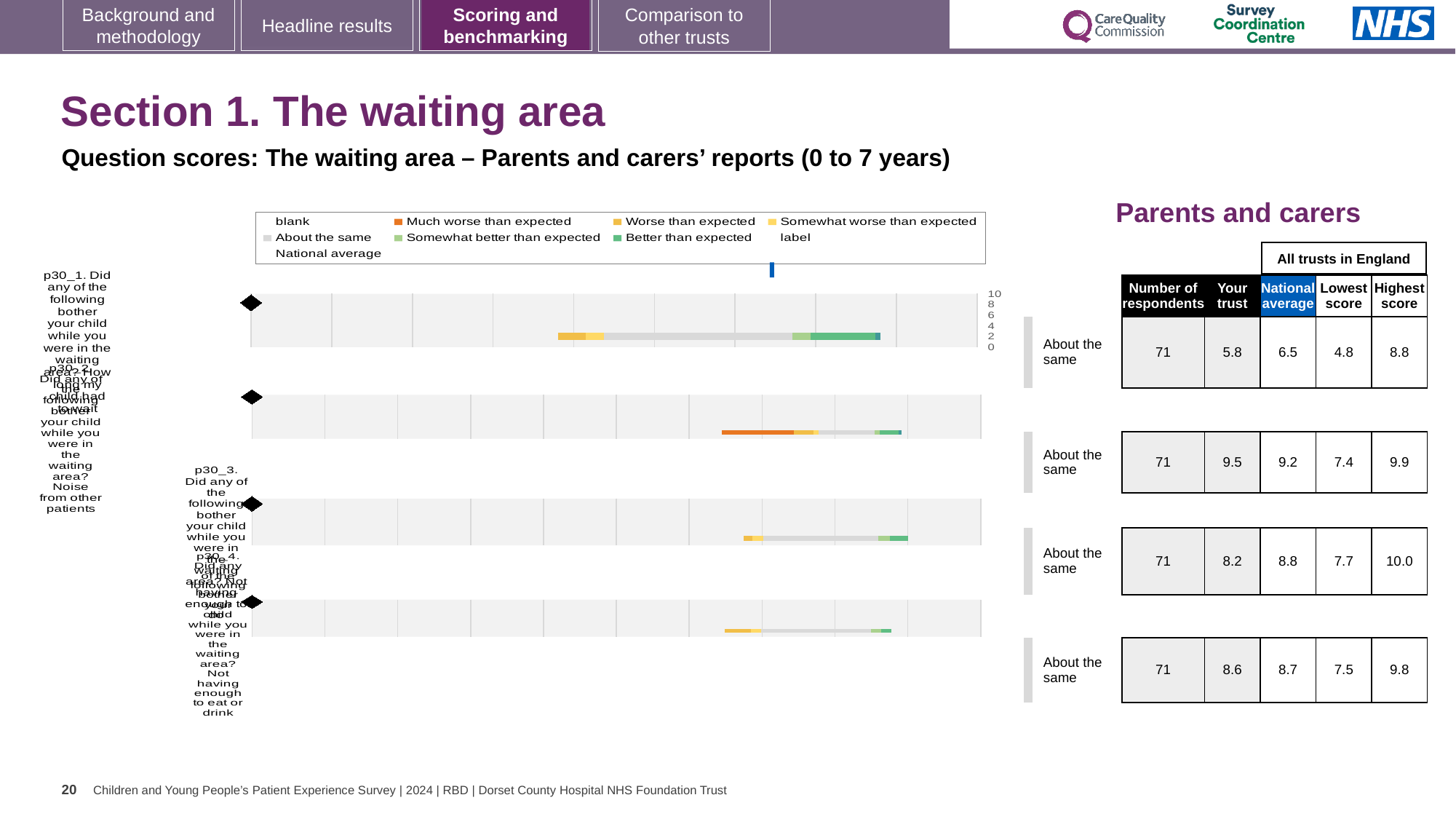
How many entries does the chart legend list? 9 In the table on the right, which row has the highest 'Your trust' score? the second row (p30_2), 9.5 For the first row (p30_1), which is larger: the 'Your trust' score or the national average? national average What kind of chart is shown on the left of the slide? bar chart In the table on the right, what is the national average for the first row (p30_1)? 6.5 For the second row (p30_2), what is the difference between the highest score and the lowest score? 2.5 In the chart legend, what colour represents 'Better than expected'? green In the chart legend, what colour represents 'Much worse than expected'? orange In the table on the right, what is the number of respondents for the first row (p30_1)? 71 In the table on the right, what is the 'Your trust' score for the first row (p30_1)? 5.8 In the table on the right, what is the highest score for the third row (p30_3)? 10.0 How many question bars are plotted in the chart? 4